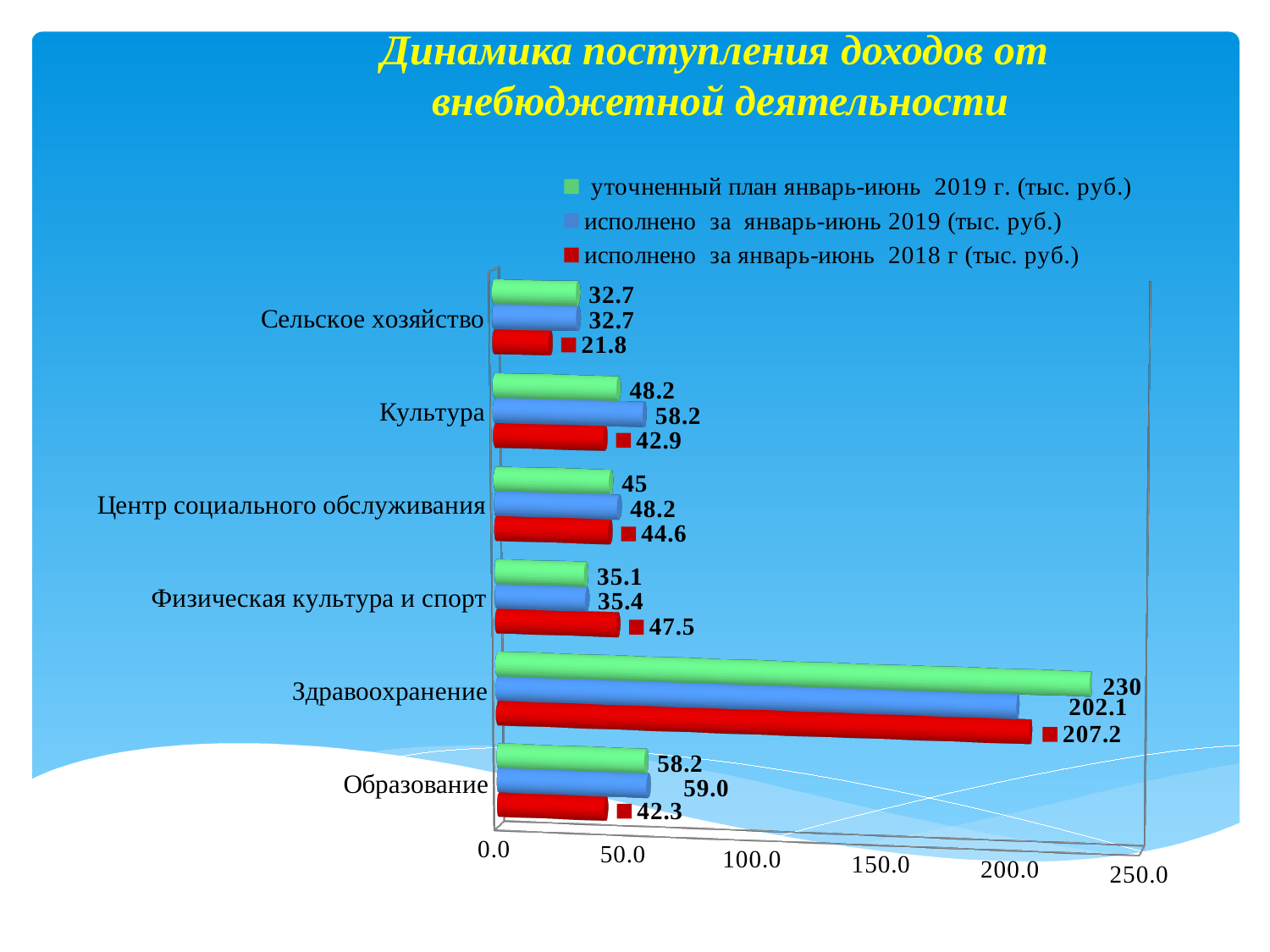
What type of chart is shown on the slide? bar chart How many categories are shown on the chart? 6 What is the value of 'исполнено за январь-июнь 2019' for Культура? 58.2 Which category has the lowest value for 'уточненный план январь-июнь 2019 г.'? Сельское хозяйство Which category has the highest value for 'исполнено за январь-июнь 2018 г'? Здравоохранение What is the value of 'исполнено за январь-июнь 2018 г' for Сельское хозяйство? 21.8 What is the title of the chart? Динамика поступления доходов от внебюджетной деятельности What is the difference between 'исполнено за январь-июнь 2018 г' and 'исполнено за январь-июнь 2019' for Здравоохранение? 5.1 How many series does the legend list? 3 What is the value of 'уточненный план январь-июнь 2019 г.' for Здравоохранение? 230 What is the value of 'исполнено за январь-июнь 2019' for Образование? 59.0 For Физическая культура и спорт, which is larger: 'исполнено за январь-июнь 2019' or 'исполнено за январь-июнь 2018 г'? исполнено за январь-июнь 2018 г